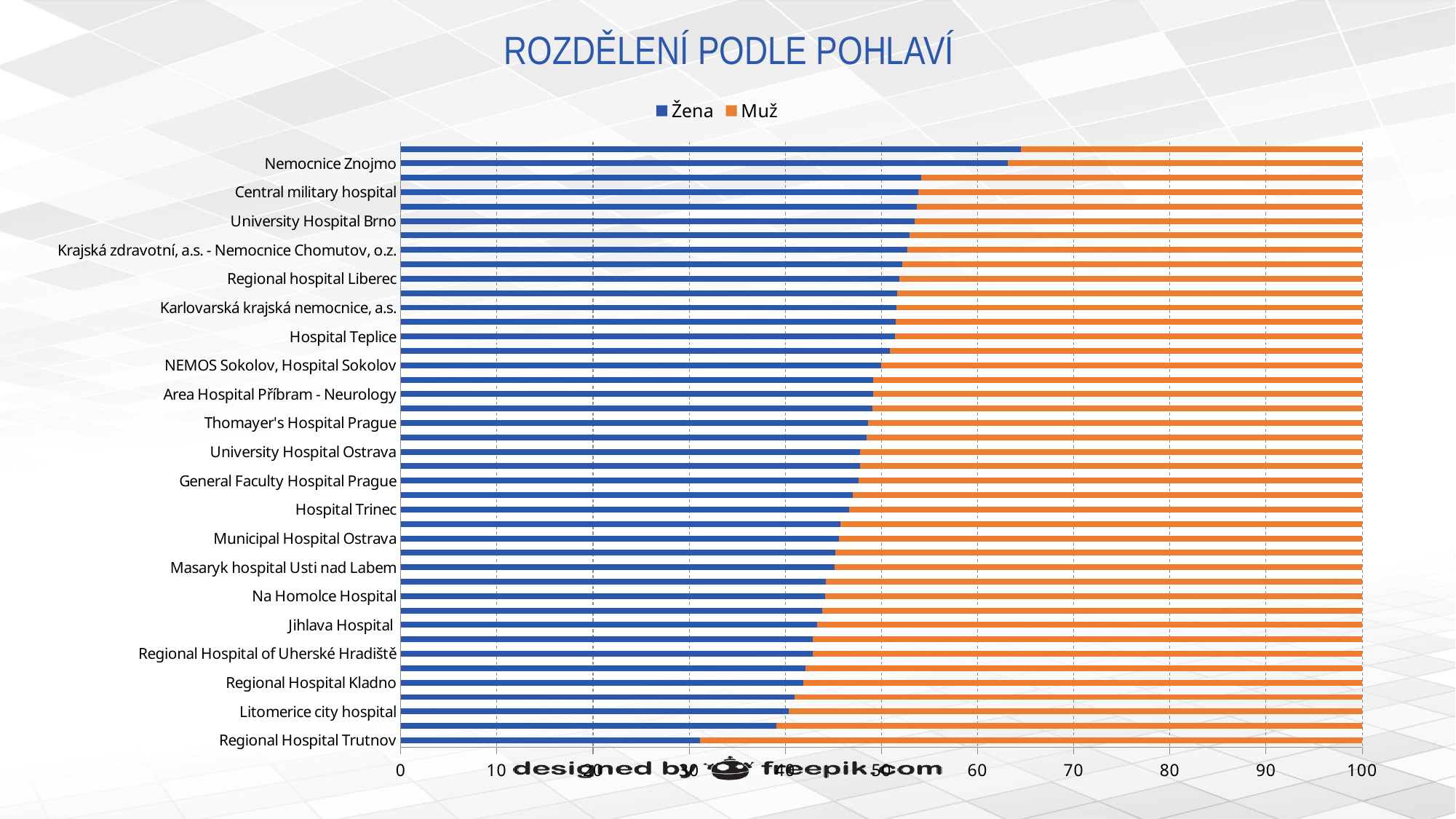
Is the Žena value for Regional Hospital Trutnov greater or less than 40? less What kind of chart is shown on the slide? Stacked bar chart Is the Žena value for Central military hospital greater or less than 50? greater Is the Žena value for Na Homolce Hospital greater or less than 50? less Which has a larger Muž share, Regional Hospital Trutnov or Central military hospital? Regional Hospital Trutnov What is the title of the chart? ROZDĚLENÍ PODLE POHLAVÍ Which series is shown in orange in the legend? Muž Which labeled hospital has the lowest Žena share? Regional Hospital Trutnov How many series does the legend list? 2 Which has a larger Žena share, Nemocnice Znojmo or Regional Hospital Trutnov? Nemocnice Znojmo